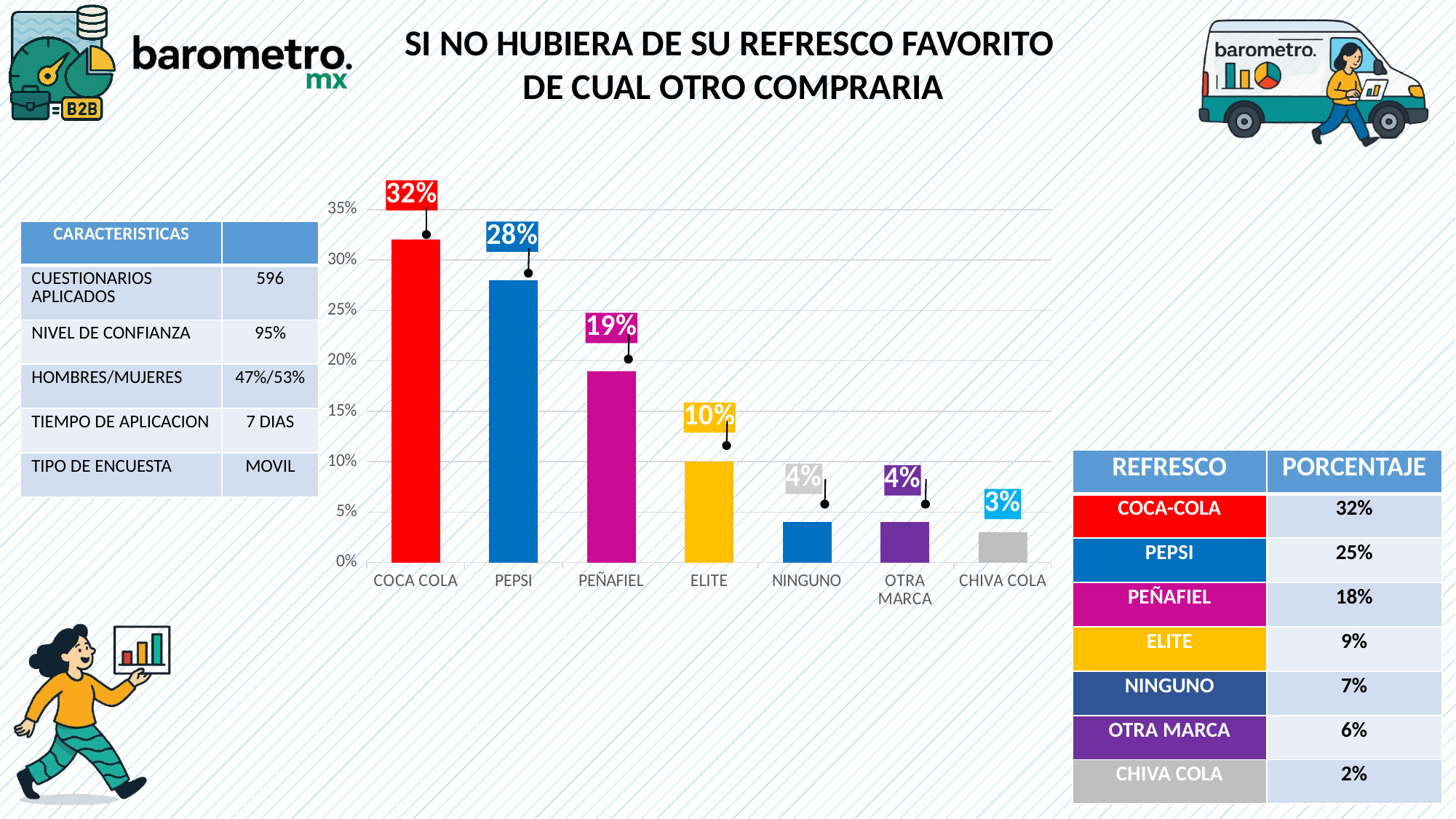
According to the bar chart's data label, what percentage is shown for PEÑAFIEL? 19% How many categories are shown on the x axis of the bar chart? 7 In the bar chart, which is larger, the value for PEÑAFIEL or the value for ELITE? PEÑAFIEL Which category has the lowest bar in the bar chart? CHIVA COLA According to the bar chart's data label, what percentage is shown for COCA COLA? 32% What type of chart is shown on the slide? bar chart Do the bar values generally rise or fall from left to right along the x axis of the bar chart? fall According to the bar chart's data label, what percentage is shown for CHIVA COLA? 3% According to the bar chart's data label, what percentage is shown for PEPSI? 28% In the bar chart, what is the difference between the data labels for COCA COLA and PEPSI? 4% Which category has the highest bar in the bar chart? COCA COLA According to the bar chart's data label, what percentage is shown for ELITE? 10%